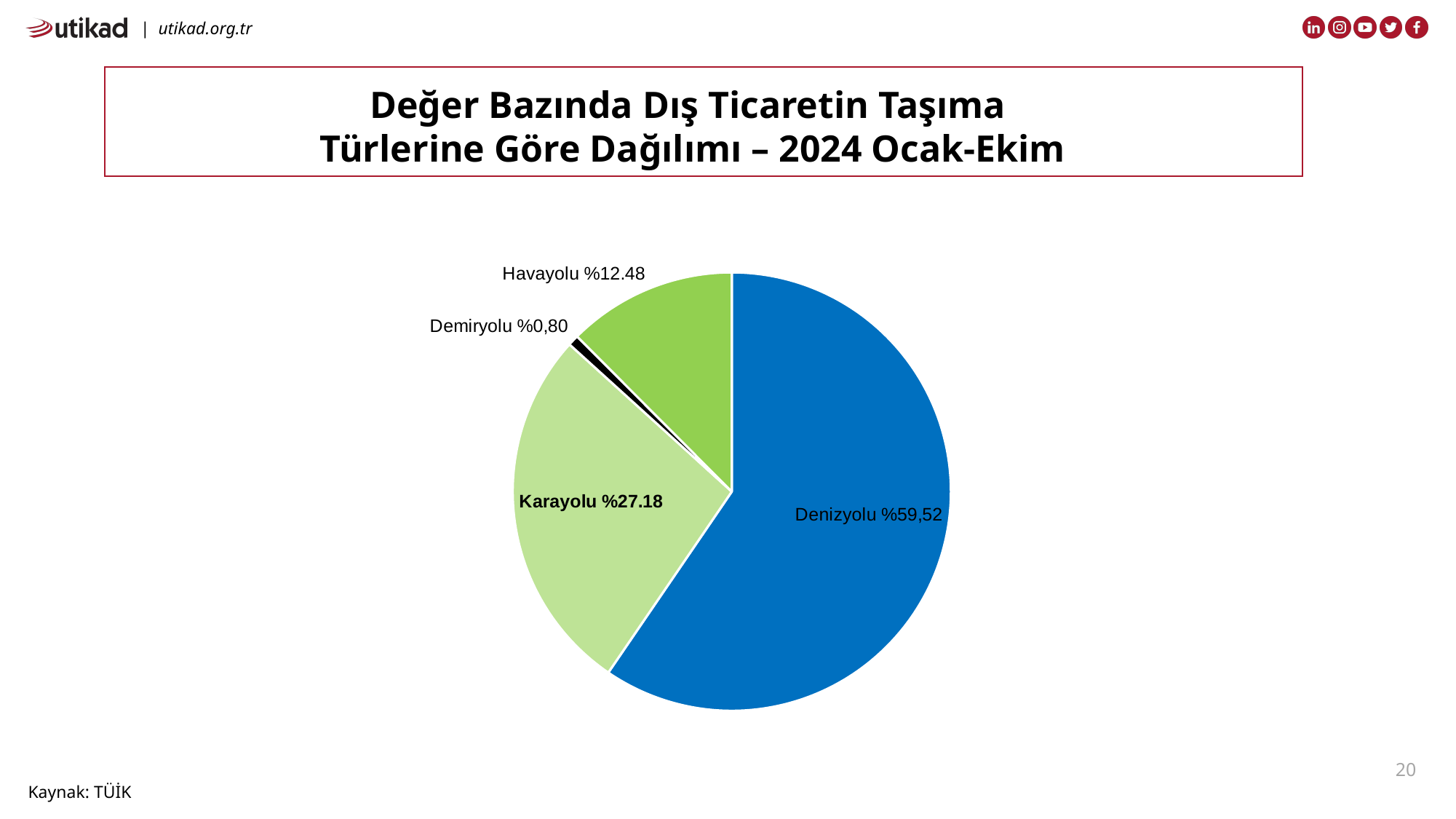
What colour is the Denizyolu slice of the pie? blue What share of the pie does Karayolu have? %27.18 What share of the pie does Demiryolu have? %0,80 What share of the pie does Havayolu have? %12.48 Which transport mode has the smallest slice of the pie? Demiryolu What share of the pie does Denizyolu have? %59,52 What is the difference in percentage points between the Denizyolu share and the Karayolu share? 32.34 Which transport mode has the largest slice of the pie? Denizyolu What is the title of the chart on the slide? Değer Bazında Dış Ticaretin Taşıma Türlerine Göre Dağılımı – 2024 Ocak-Ekim What kind of chart is shown on the slide? pie chart Which is larger, the share for Karayolu or the share for Havayolu? Karayolu How many slices does the pie chart have? 4